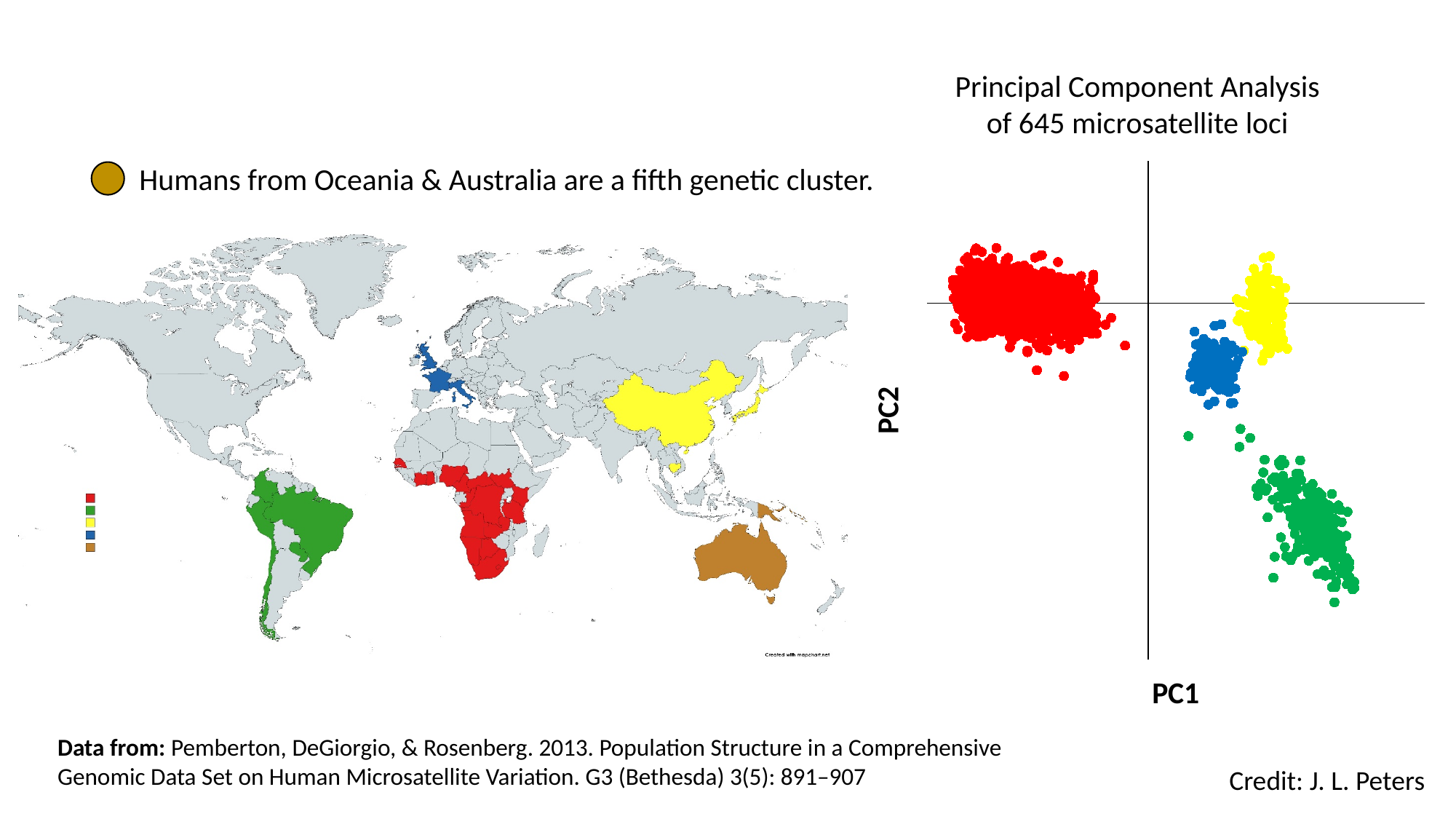
What kind of chart is the Principal Component Analysis plot on the right of the slide? scatter plot In the Principal Component Analysis chart, which coloured cluster lies furthest left on the PC1 axis? red How many differently coloured clusters of points are shown in the Principal Component Analysis chart? 4 In the Principal Component Analysis chart, is the red cluster to the left or to the right of the vertical axis? left How many colours are listed in the legend of the world map on the left of the slide? 5 In the Principal Component Analysis chart, which coloured cluster lies furthest right on the PC1 axis? green In the Principal Component Analysis chart, what is the label of the vertical axis? PC2 In the Principal Component Analysis chart, which cluster is higher on the PC2 axis, the blue cluster or the green cluster? blue What is the title of the chart on the right of the slide? Principal Component Analysis of 645 microsatellite loci In the Principal Component Analysis chart, which coloured cluster lies lowest on the PC2 axis? green In the Principal Component Analysis chart, what is the label of the horizontal axis? PC1